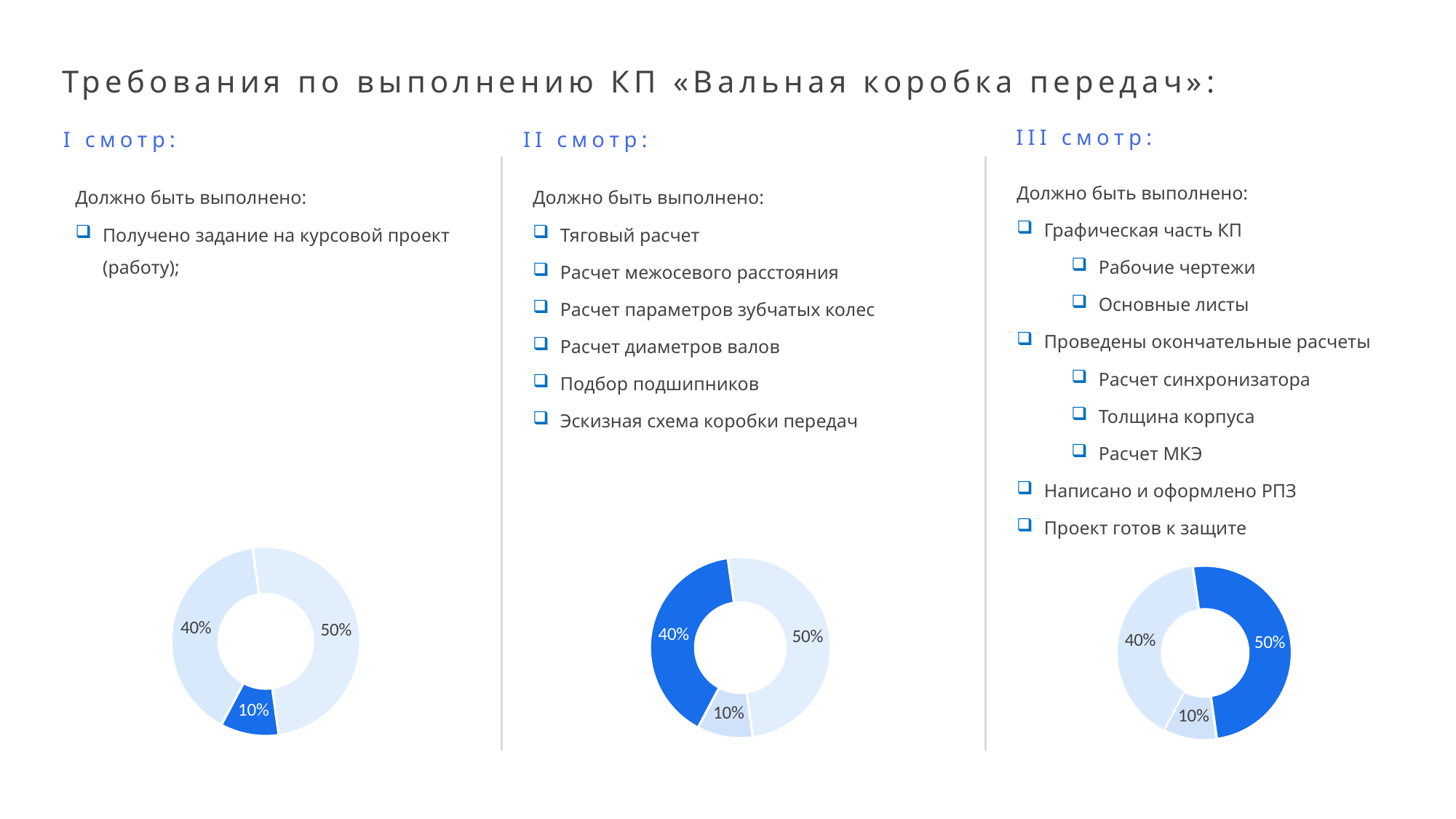
What is the largest slice value in the donut chart under "I смотр"? 50% In the donut chart under "II смотр", which is larger: the 40% slice or the 10% slice? 40% How many donut charts are shown on the slide? 3 What is the smallest slice value in the donut chart under "III смотр"? 10% In the donut chart under "III смотр", what is the difference between the 50% slice and the 40% slice? 10% In the donut chart under "III смотр", which slice is highlighted in dark blue? 50% In the donut chart under "I смотр", which slice is highlighted in dark blue? 10% How many slices does the donut chart under "II смотр" have? 3 What are the three slice values shown in the donut chart under "II смотр"? 50%, 40%, 10% What do the three slice values in the donut chart under "I смотр" add up to? 100% What kind of chart is shown at the bottom of the left column (under "I смотр")? Donut chart In the donut chart under "II смотр", what is the difference between the largest and smallest slices? 40%